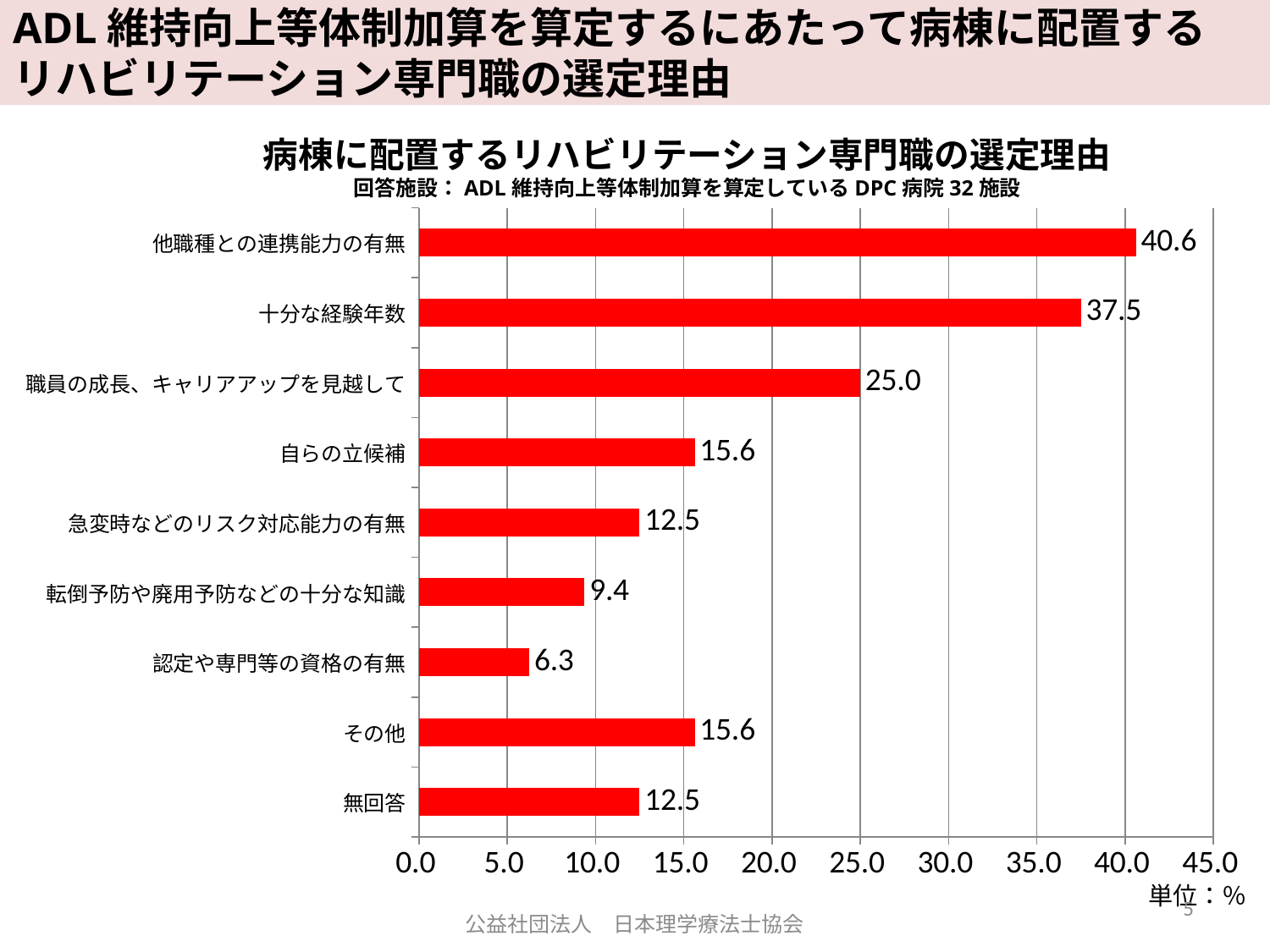
What is the difference between the values for 職員の成長、キャリアアップを見越して and 自らの立候補? 9.4 What is the value for 転倒予防や廃用予防などの十分な知識? 9.4 Which category has the lowest value? 認定や専門等の資格の有無 How many categories are shown in the chart? 9 Which is larger, the value for 急変時などのリスク対応能力の有無 or the value for 転倒予防や廃用予防などの十分な知識? 急変時などのリスク対応能力の有無 What is the value for 十分な経験年数? 37.5 What unit is indicated for the values in the chart? % What is the value for 他職種との連携能力の有無? 40.6 What kind of chart is this? bar chart What is the difference between the values for 他職種との連携能力の有無 and 十分な経験年数? 3.1 What is the value for 認定や専門等の資格の有無? 6.3 Which category has the highest value? 他職種との連携能力の有無